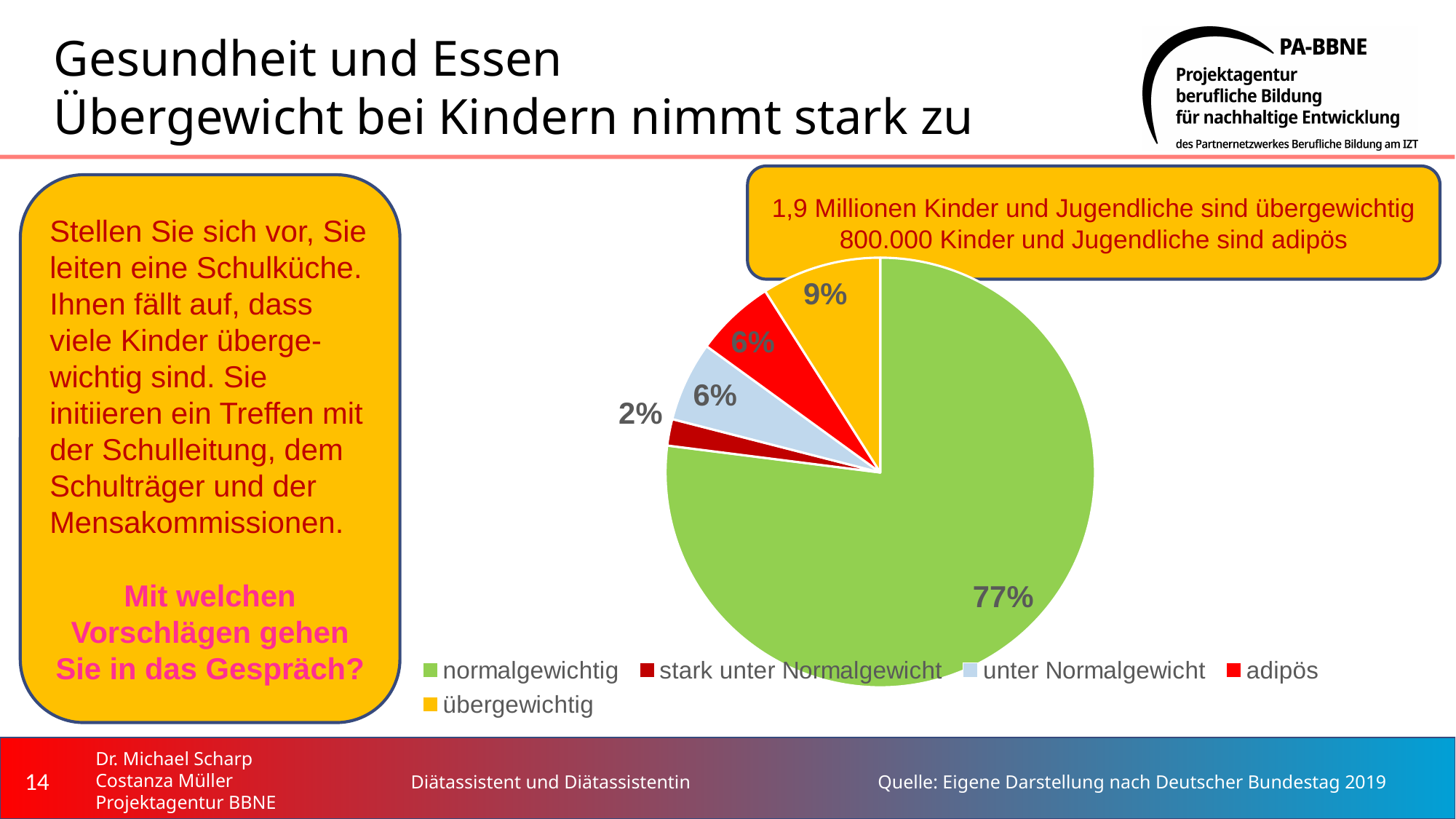
What share of the pie is labelled "unter Normalgewicht"? 6% How many categories does the legend of the pie chart list? 5 Which is larger, the share for "übergewichtig" or the share for "adipös"? übergewichtig What kind of chart is shown on the slide? pie chart Which category has the largest slice of the pie? normalgewichtig What is the difference between the share for "normalgewichtig" and the share for "übergewichtig"? 68% What share of the pie is labelled "stark unter Normalgewicht"? 2% Which category has the smallest slice of the pie? stark unter Normalgewicht What share of the pie is labelled "adipös"? 6% What colour is the slice for "übergewichtig"? yellow What share of the pie is labelled "übergewichtig"? 9% What share of the pie is labelled "normalgewichtig"? 77%